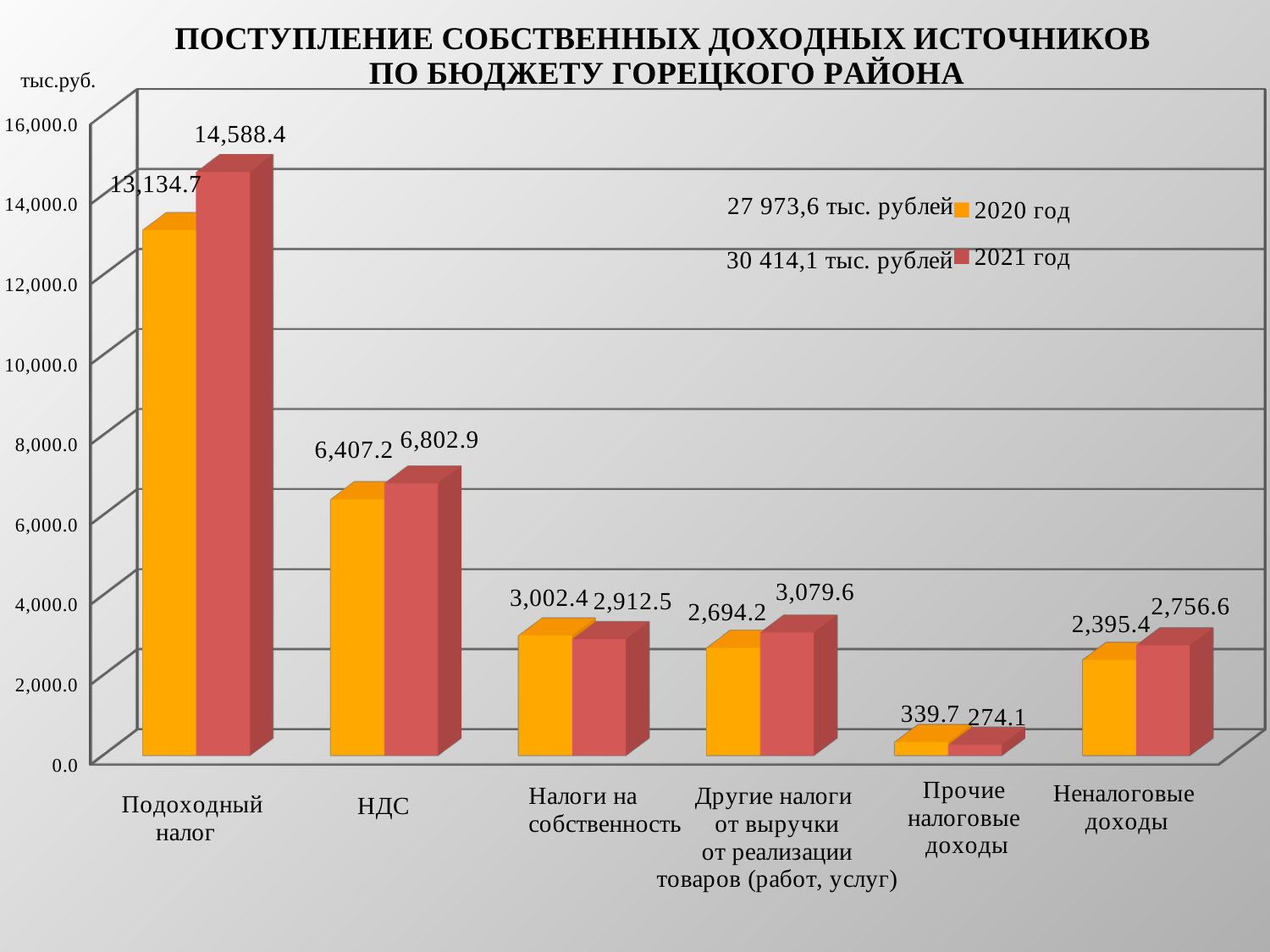
What is the value for Прочие налоговые доходы in the 2020 год series? 339.7 Which category has the lowest value in the 2020 год series? Прочие налоговые доходы What is the value for Подоходный налог in the 2021 год series? 14,588.4 What is the value for НДС in the 2020 год series? 6,407.2 What is the value for Неналоговые доходы in the 2021 год series? 2,756.6 What is the difference between the 2020 год and 2021 год values for Налоги на собственность? 89.9 Which category has the highest value in the 2021 год series? Подоходный налог How many series does the legend list? 2 How many categories are shown on the x axis? 6 Which is larger for Налоги на собственность: the 2020 год value or the 2021 год value? 2020 год What is the difference between the 2021 год and 2020 год values for Подоходный налог? 1,453.7 What kind of chart is shown on the slide? Bar chart